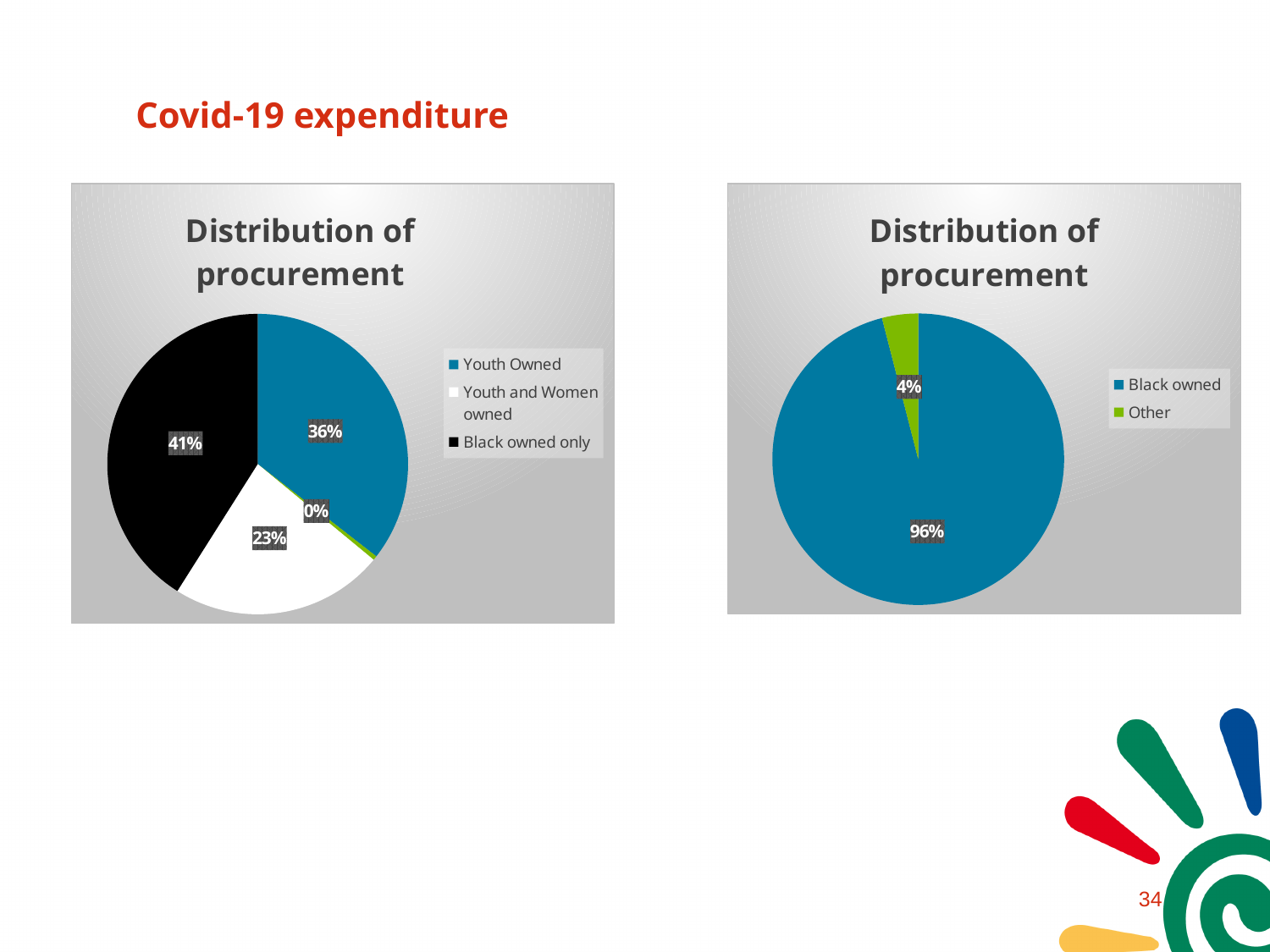
In the left pie chart, what percentage is Youth Owned? 36% In the left pie chart, what is the difference between the Black owned only share and the Youth Owned share? 5% In the left pie chart, which of the three legend categories has the smallest share? Youth and Women owned How many entries does the legend of the left pie chart list? 3 In the right pie chart, what percentage is Other? 4% In the left pie chart, which category has the largest share? Black owned only In the left pie chart, what percentage is Youth and Women owned? 23% In the left pie chart, which is larger: Youth Owned or Youth and Women owned? Youth Owned In the right pie chart, what percentage is Black owned? 96% In the right pie chart, what is the difference between the Black owned share and the Other share? 92% In the left pie chart, what percentage is Black owned only? 41% What type of chart is the right chart? Pie chart